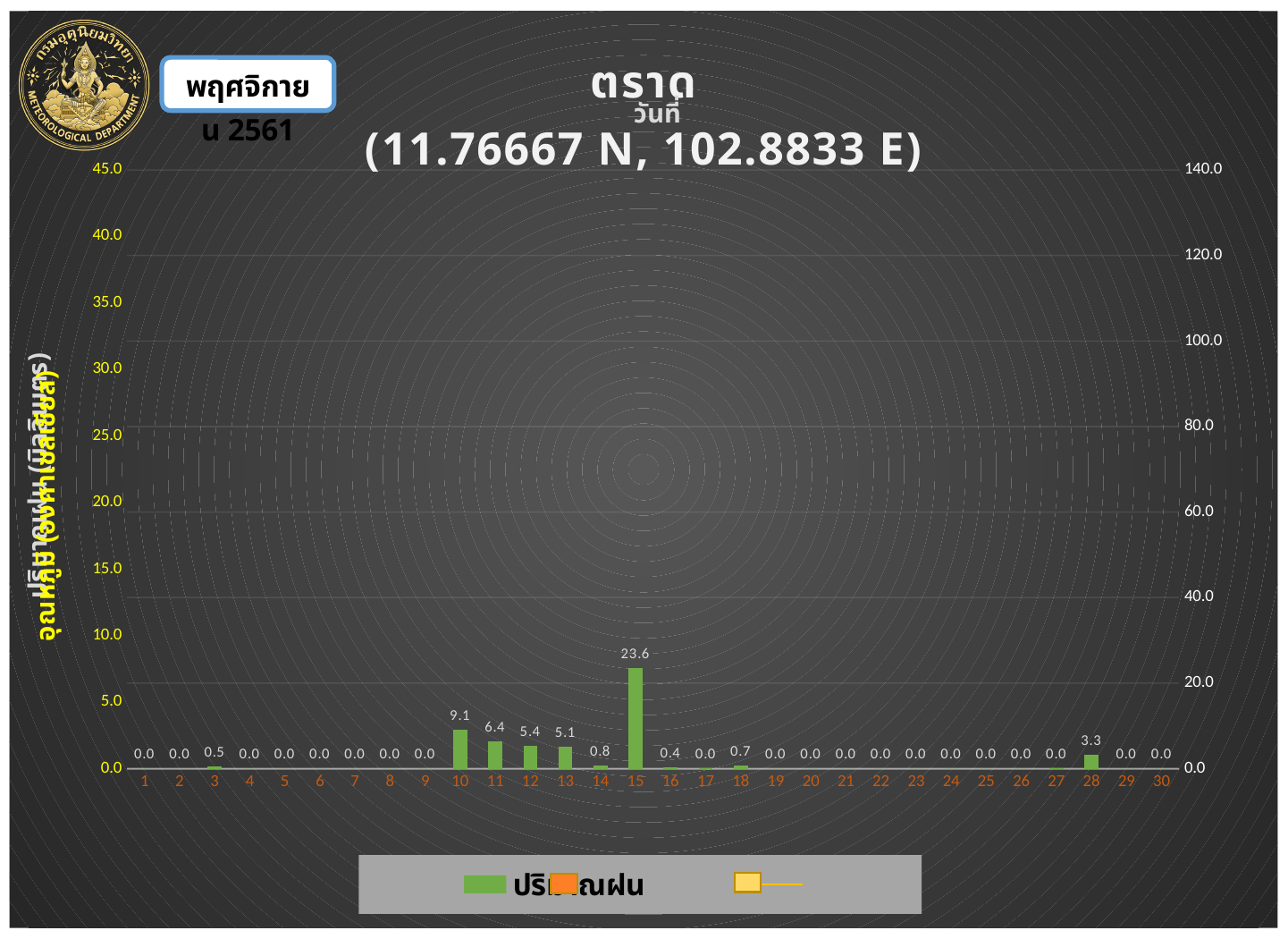
What is the rainfall value shown for day 10? 9.1 What is the difference between the rainfall values for day 11 and day 12? 1.0 Which day has the highest rainfall value? 15 How many days are shown on the x axis? 30 What kind of chart is used to show the rainfall values? bar chart What is the rainfall value shown for day 3? 0.5 What is the rainfall value shown for day 28? 3.3 Which has the larger rainfall value, day 13 or day 28? day 13 What coordinates are given in the chart title? 11.76667 N, 102.8833 E What is the rainfall value shown for day 15? 23.6 Is the rainfall value for day 15 greater or less than 20.0 on the right axis? greater What is the difference between the rainfall values for day 15 and day 10? 14.5